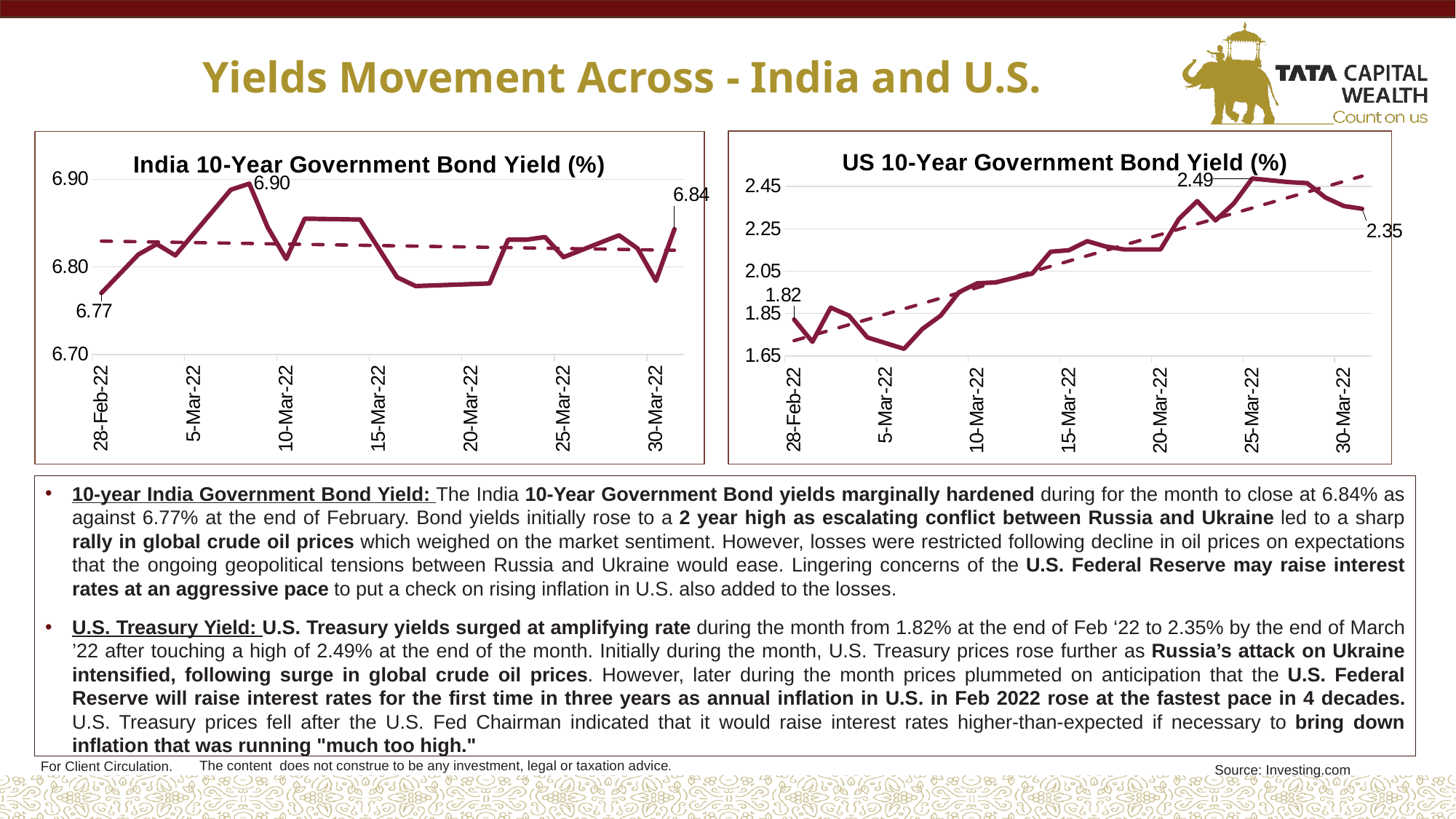
In the US 10-Year Government Bond Yield (%) chart, is the value around 5-Mar-22 greater or less than 1.85? less In the US 10-Year Government Bond Yield (%) chart, what is the highest labelled value? 2.49 Which chart shows a larger closing value, the India chart at 6.84 or the US chart at 2.35? India 10-Year Government Bond Yield (%) In the US 10-Year Government Bond Yield (%) chart, what is the value labelled at the end of the series? 2.35 In the India 10-Year Government Bond Yield (%) chart, what is the value labelled at the end of the series? 6.84 In the India 10-Year Government Bond Yield (%) chart, what is the value labelled at the start of the series on 28-Feb-22? 6.77 In the US 10-Year Government Bond Yield (%) chart, what is the value labelled at the start of the series on 28-Feb-22? 1.82 What kind of chart is the US 10-Year Government Bond Yield (%) chart? line chart In the US 10-Year Government Bond Yield (%) chart, what is the difference between the peak value 2.49 and the closing value 2.35? 0.14 In the India 10-Year Government Bond Yield (%) chart, what is the highest labelled value? 6.90 In the US 10-Year Government Bond Yield (%) chart, do the values generally rise or fall from 28-Feb-22 to 30-Mar-22? rise In the India 10-Year Government Bond Yield (%) chart, what is the difference between the closing value 6.84 and the starting value 6.77? 0.07